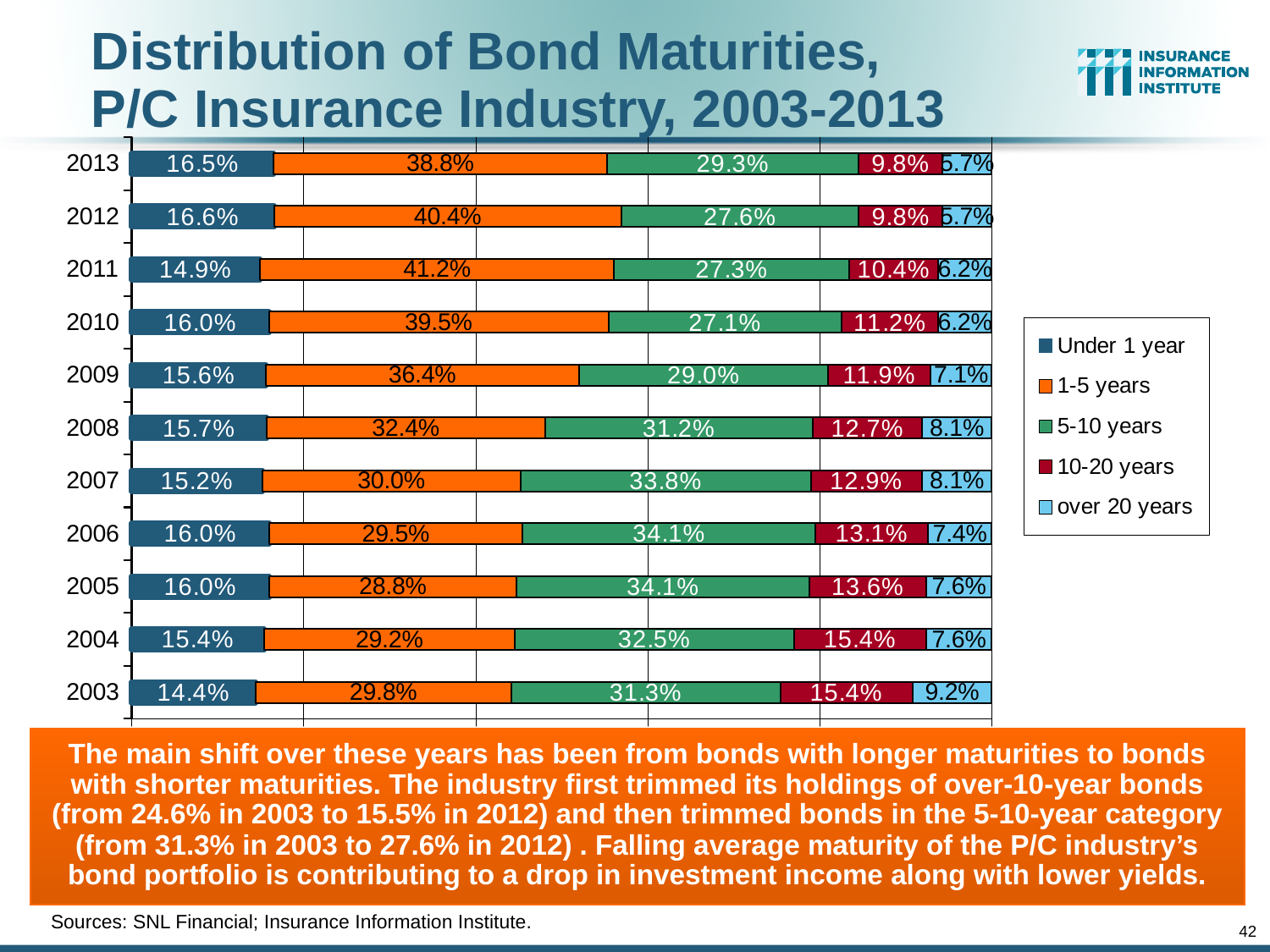
In which year was the over 20 years share the highest? 2003 What share of bonds had maturities of 1-5 years in 2013? 38.8% What share of bonds had maturities of 5-10 years in 2003? 31.3% Which year had a larger 5-10 years share, 2006 or 2013? 2006 By how many percentage points did the 1-5 years share in 2013 exceed that in 2003? 9.0 percentage points In which year was the 1-5 years share the highest? 2011 What was the share of bonds with maturities under 1 year in 2011? 14.9% What colour represents the 1-5 years series in the chart? Orange Did the 1-5 years share generally rise or fall from 2003 to 2013? Rise What kind of chart is shown on the slide? Stacked bar chart How many years are shown on the chart? 11 How many series does the legend list? 5